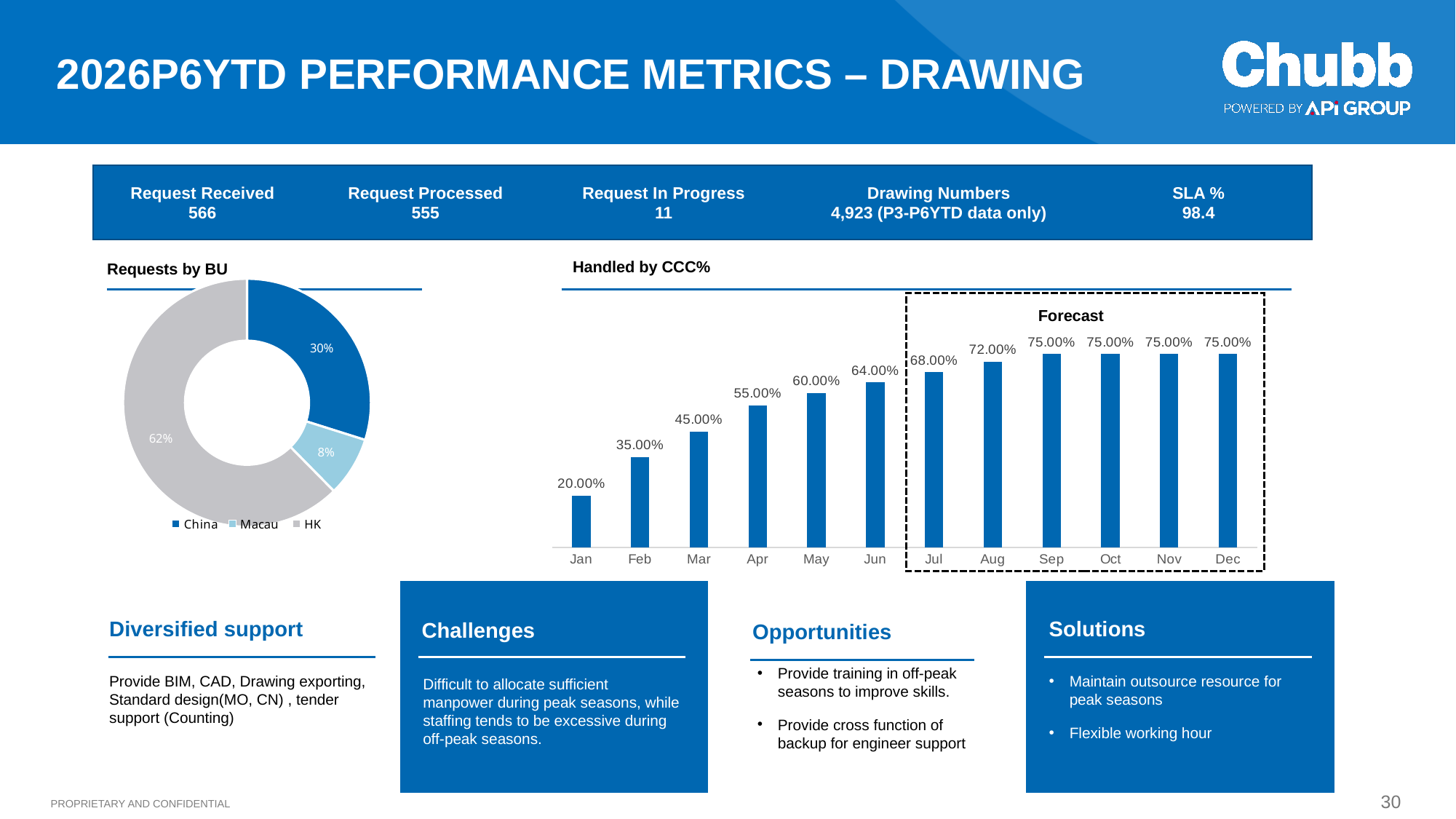
In the 'Requests by BU' chart, which BU has the largest share of requests? HK In the 'Requests by BU' chart, what share of requests comes from HK? 62% What kind of chart is the 'Requests by BU' chart? Doughnut (pie) chart In the 'Requests by BU' chart, how many BUs does the legend list? 3 In the 'Handled by CCC%' chart, what is the value for Jan? 20.00% In the 'Handled by CCC%' chart, how many months are plotted? 12 In the 'Handled by CCC%' chart, which month has the lowest value? Jan In the 'Requests by BU' chart, what share of requests comes from Macau? 8% In the 'Requests by BU' chart, which BU has the smallest share of requests? Macau In the 'Handled by CCC%' chart, do the values rise or fall from Jan to Sep? Rise In the 'Handled by CCC%' chart, what is the value for Jun? 64.00% In the 'Handled by CCC%' chart, what is the difference between the values for Aug and Jul? 4.00%